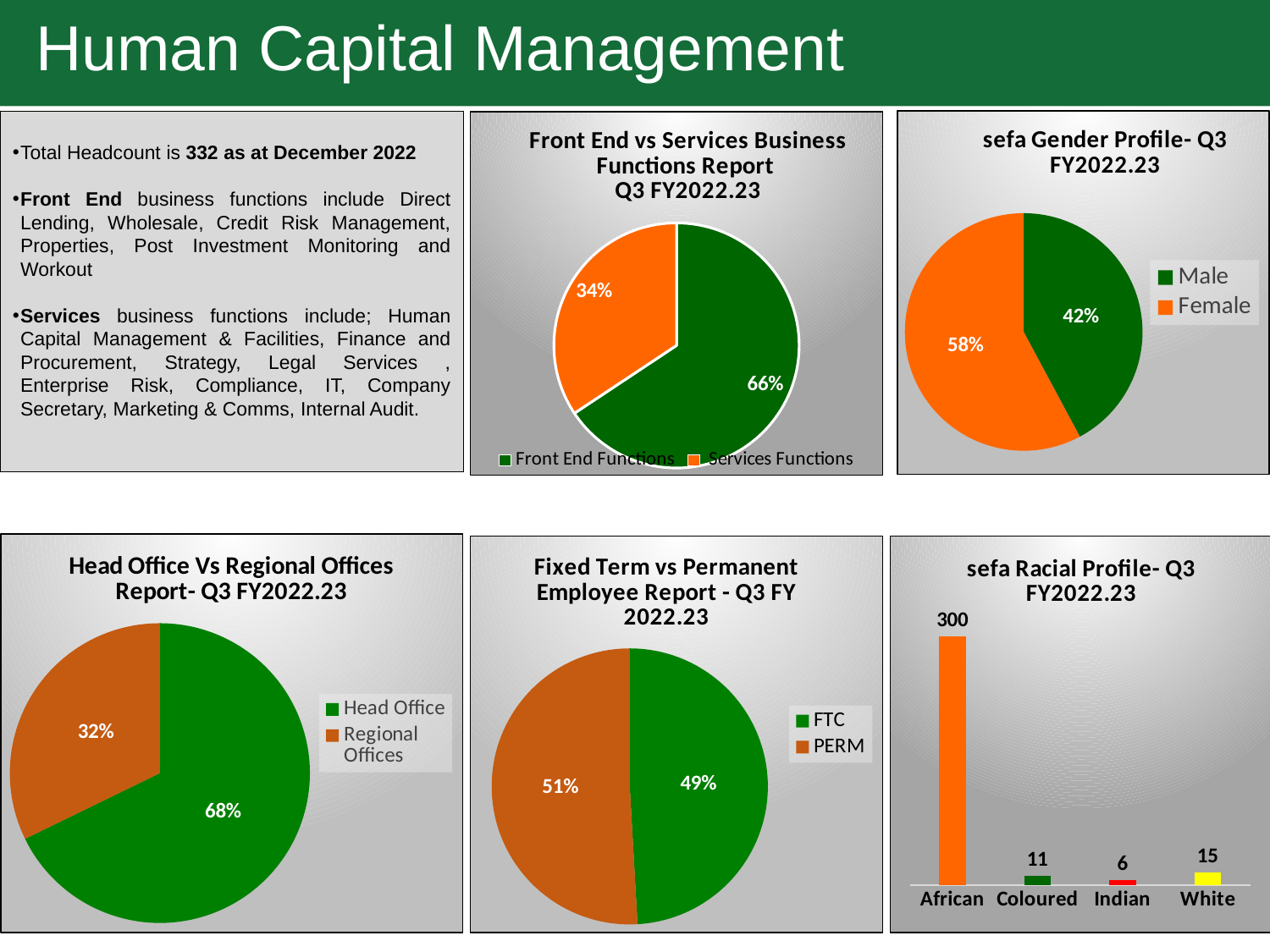
In the 'sefa Racial Profile- Q3 FY2022.23' chart, what is the value for African? 300 What kind of chart is the 'Head Office Vs Regional Offices Report- Q3 FY2022.23' chart? Pie chart In the 'sefa Gender Profile- Q3 FY2022.23' chart, what percentage is Female? 58% In the 'sefa Racial Profile- Q3 FY2022.23' chart, which category has the lowest value? Indian In the 'Head Office Vs Regional Offices Report- Q3 FY2022.23' chart, what share is Head Office? 68% How many categories are shown in the 'sefa Racial Profile- Q3 FY2022.23' chart? 4 In the 'sefa Racial Profile- Q3 FY2022.23' chart, what is the difference between the White and Coloured values? 4 In the 'sefa Gender Profile- Q3 FY2022.23' chart, what is the difference between the Female and Male percentages? 16% In the 'sefa Gender Profile- Q3 FY2022.23' chart, which is larger, Male or Female? Female In the 'Front End vs Services Business Functions Report Q3 FY2022.23' chart, what share is Front End Functions? 66% In the 'Fixed Term vs Permanent Employee Report - Q3 FY 2022.23' chart, what percentage is PERM? 51% In the 'Front End vs Services Business Functions Report Q3 FY2022.23' chart, what share is Services Functions? 34%